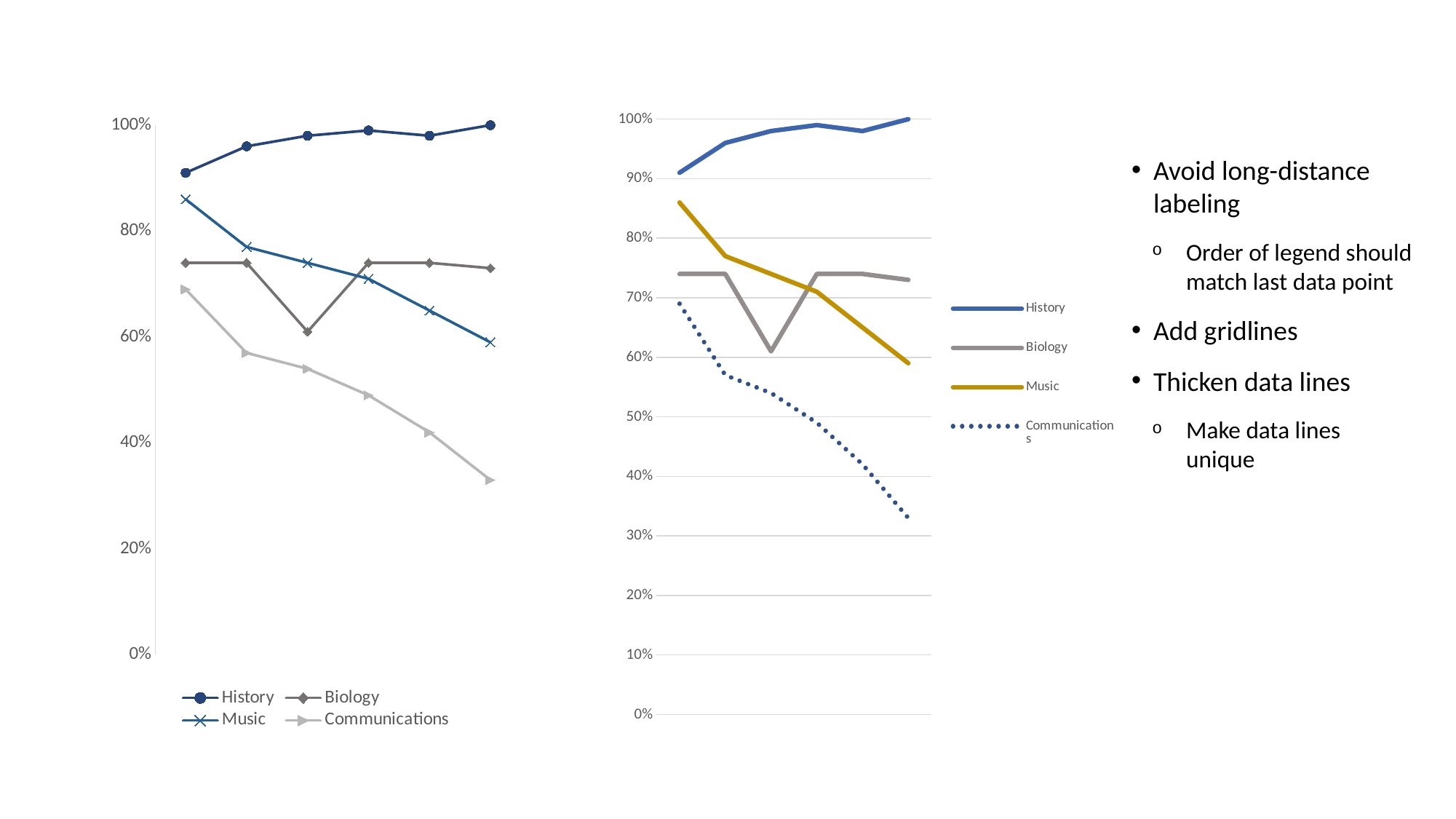
How many series does the legend of the right chart list? 4 In the right chart, does the History line generally rise or fall along the x axis? rise How many data points does the History line have in the left chart? 6 In the right chart, is the last value of the Communications line greater or less than 30%? greater What kind of chart is the left chart? line chart In the right chart, which series has the lowest value at the last data point? Communications In the right chart, which series has the highest value at the last data point? History In the left chart, does the Communications line rise or fall along the x axis? fall In the right chart, which series is drawn with a dotted line? Communications In the right chart, at the last data point, which is larger: Biology or Music? Biology